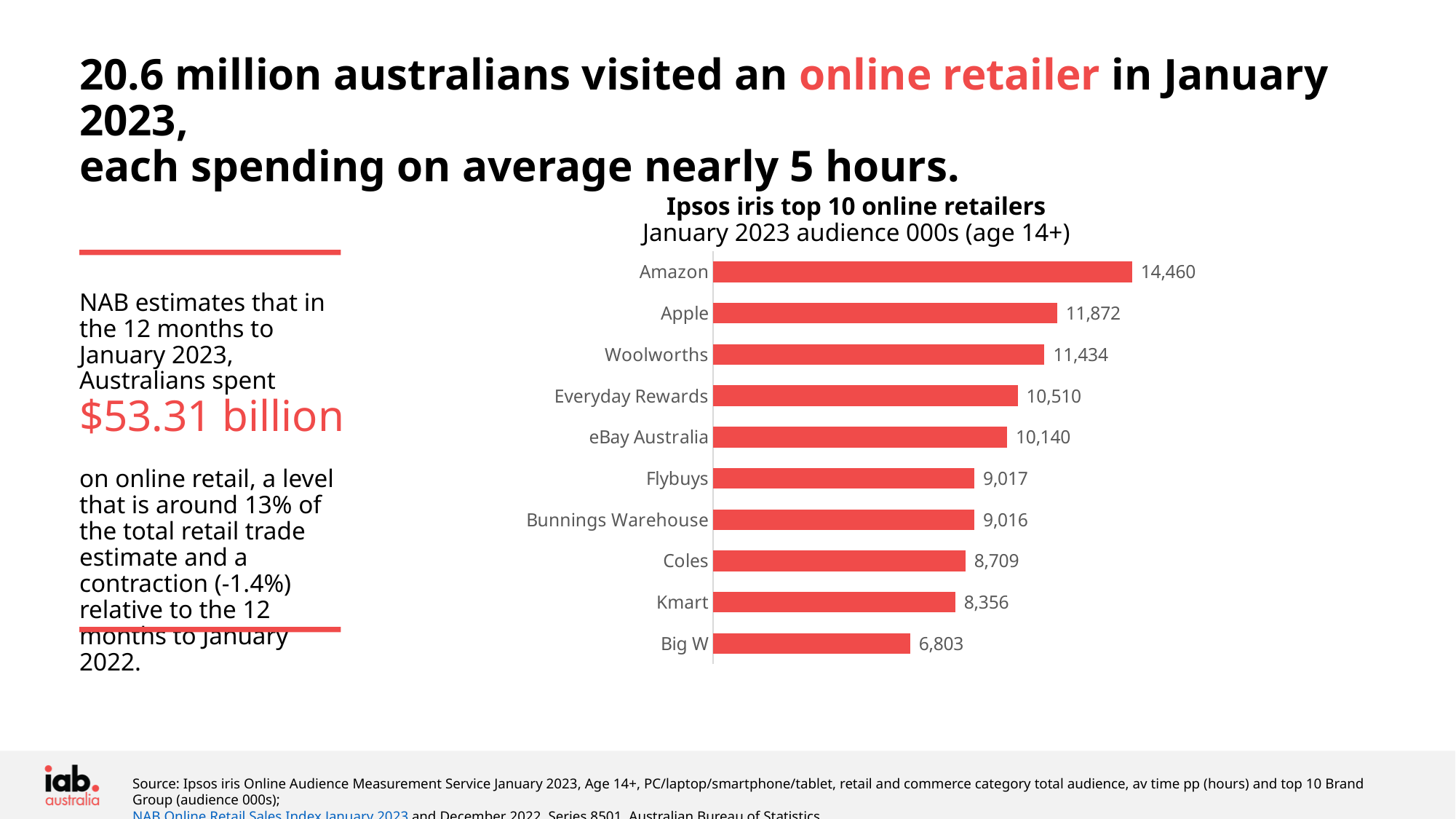
What colour are the bars in the chart? Red What kind of chart is used to show the top 10 online retailers? Bar chart What is the January 2023 audience (000s) for eBay Australia? 10,140 Which online retailer has the lowest audience in the chart? Big W What is the January 2023 audience (000s) for Coles? 8,709 Which has a larger audience, Woolworths or Everyday Rewards? Woolworths What is the title of the chart? Ipsos iris top 10 online retailers What is the difference in audience (000s) between Amazon and Apple? 2,588 How many online retailers are shown in the chart? 10 Which online retailer has the highest audience in the chart? Amazon What is the January 2023 audience (000s) for Amazon? 14,460 What is the difference in audience (000s) between Kmart and Big W? 1,553